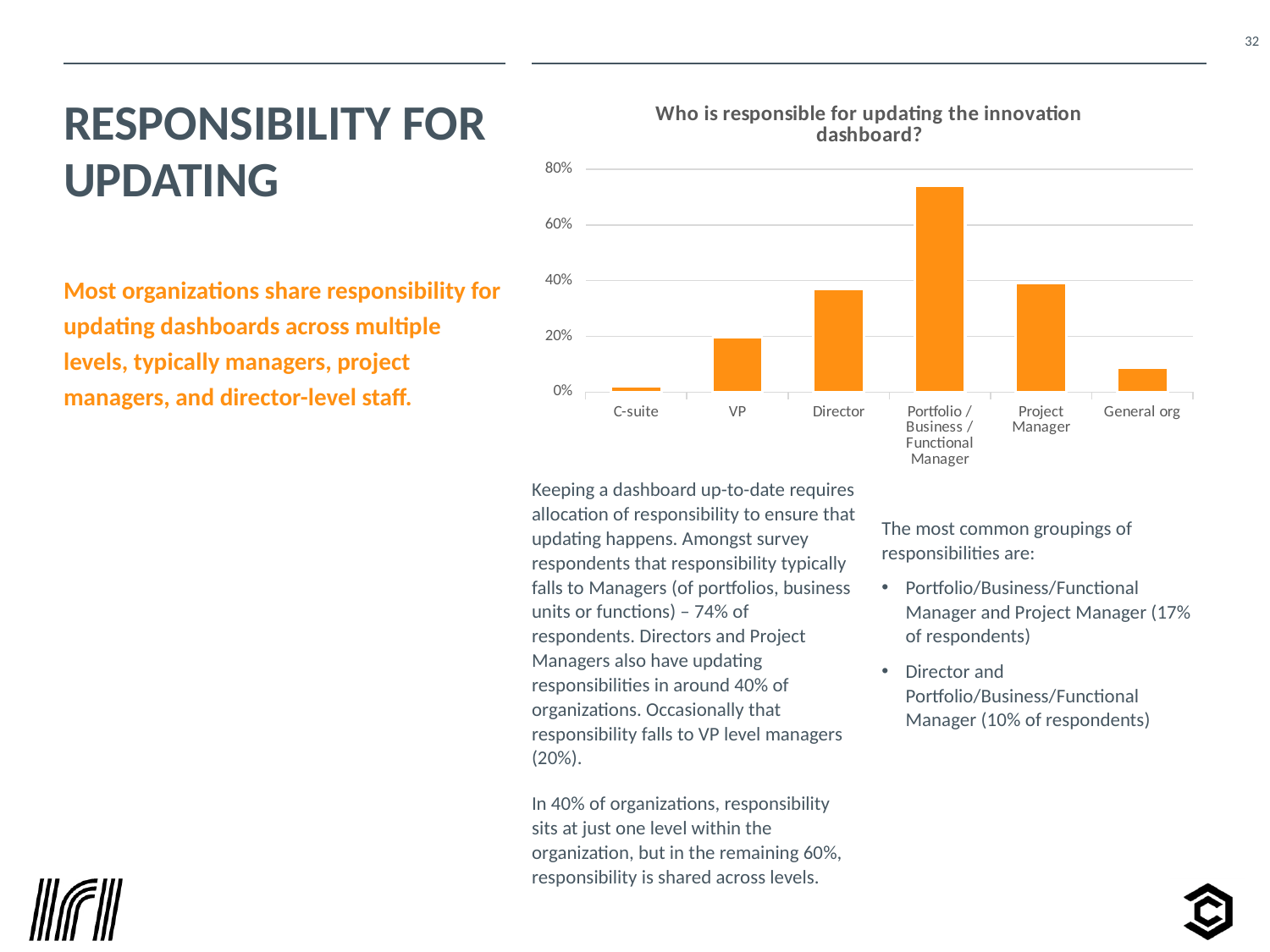
Which category has the highest value in the chart? Portfolio / Business / Functional Manager Which category has the lowest value in the chart? C-suite Which has a larger value, VP or Director? Director How many categories are shown on the x axis of the chart? 6 Is the value for Project Manager greater or less than 60%? less What kind of chart is shown on the slide? bar chart Which has a larger value, General org or VP? VP Is the value for Director greater or less than 20%? greater Is the value for Portfolio / Business / Functional Manager greater or less than 60%? greater What is the title of the chart? Who is responsible for updating the innovation dashboard?